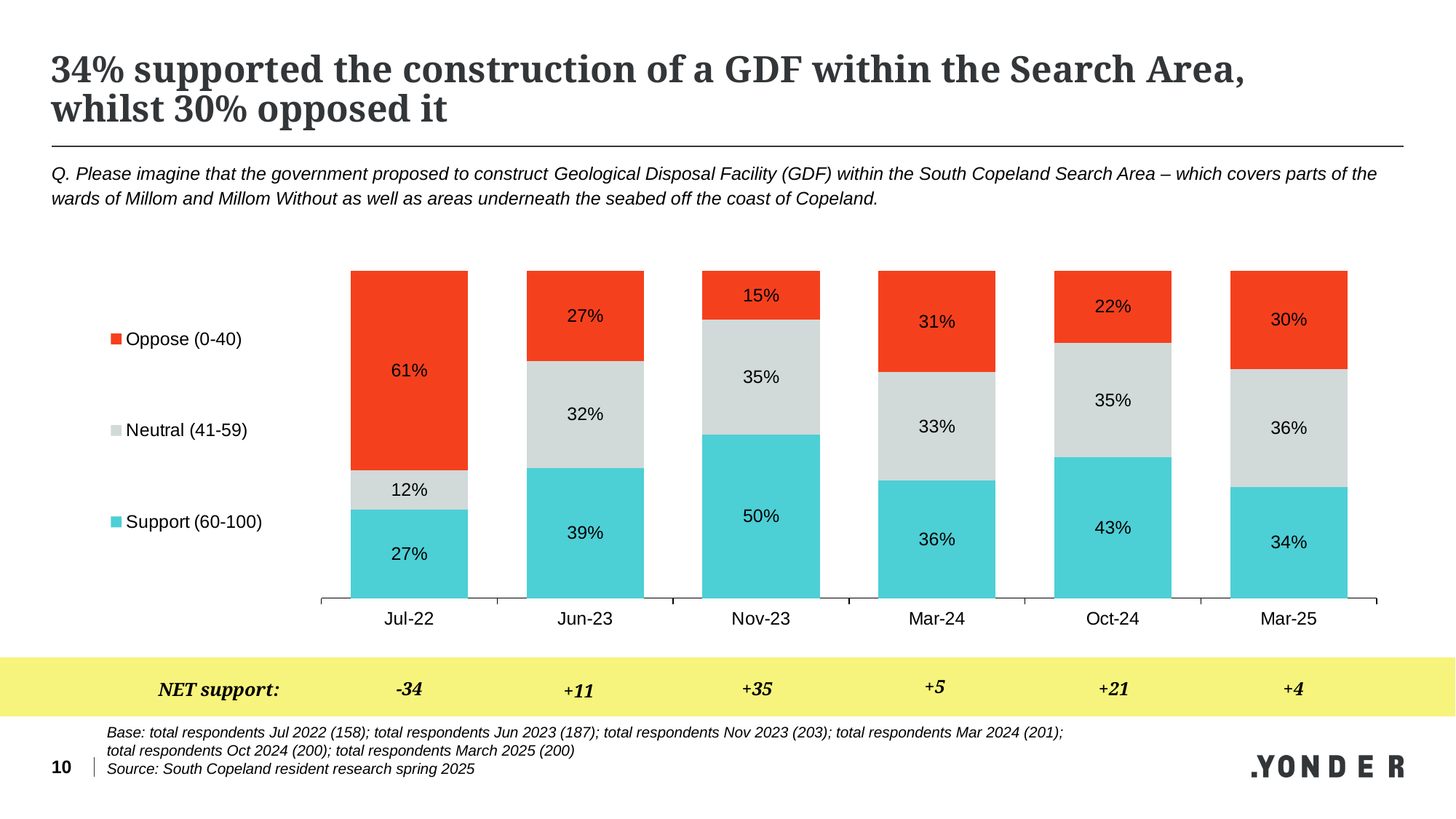
What percentage of respondents opposed (0-40) the GDF in Jul-22? 61% What kind of chart is shown on the slide? Stacked bar chart How many survey waves are shown on the x axis? 6 Which colour represents Oppose (0-40) in the legend? Red In which survey wave was the Oppose (0-40) share lowest? Nov-23 How many series does the legend list? 3 What is the NET support figure shown for Jul-22? -34 What percentage of respondents supported (60-100) the GDF in Mar-25? 34% In which survey wave was the Support (60-100) share highest? Nov-23 Which is larger in Mar-24: the Oppose share or the Support share? Support (36%) What is the difference between the Support share in Oct-24 and the Support share in Mar-25? 9 percentage points What was the Neutral (41-59) share in Nov-23? 35%